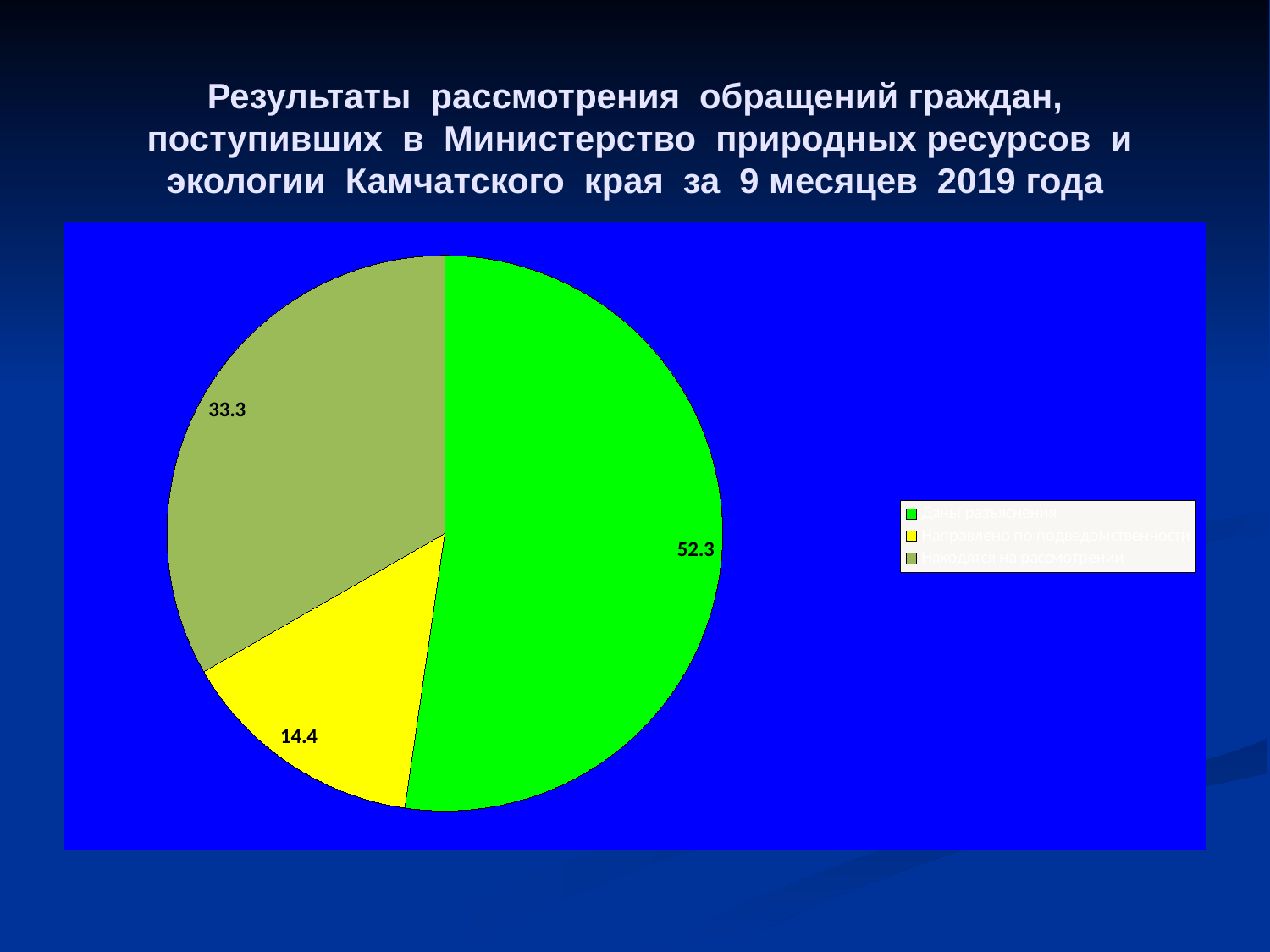
How many entries does the legend of the pie chart list? 3 Which slice of the pie chart has the largest value? the green slice (52.3) What is the difference between the green slice and the olive slice in the pie chart? 19.0 What kind of chart is shown on the slide? pie chart Which is larger in the pie chart, the yellow slice or the olive slice? the olive slice What value is shown on the yellow slice of the pie chart? 14.4 What value is shown on the green slice of the pie chart? 52.3 How many slices does the pie chart have? 3 Which slice of the pie chart has the smallest value? the yellow slice (14.4) What is the difference between the olive slice and the yellow slice in the pie chart? 18.9 What value is shown on the olive (grey-green) slice of the pie chart? 33.3